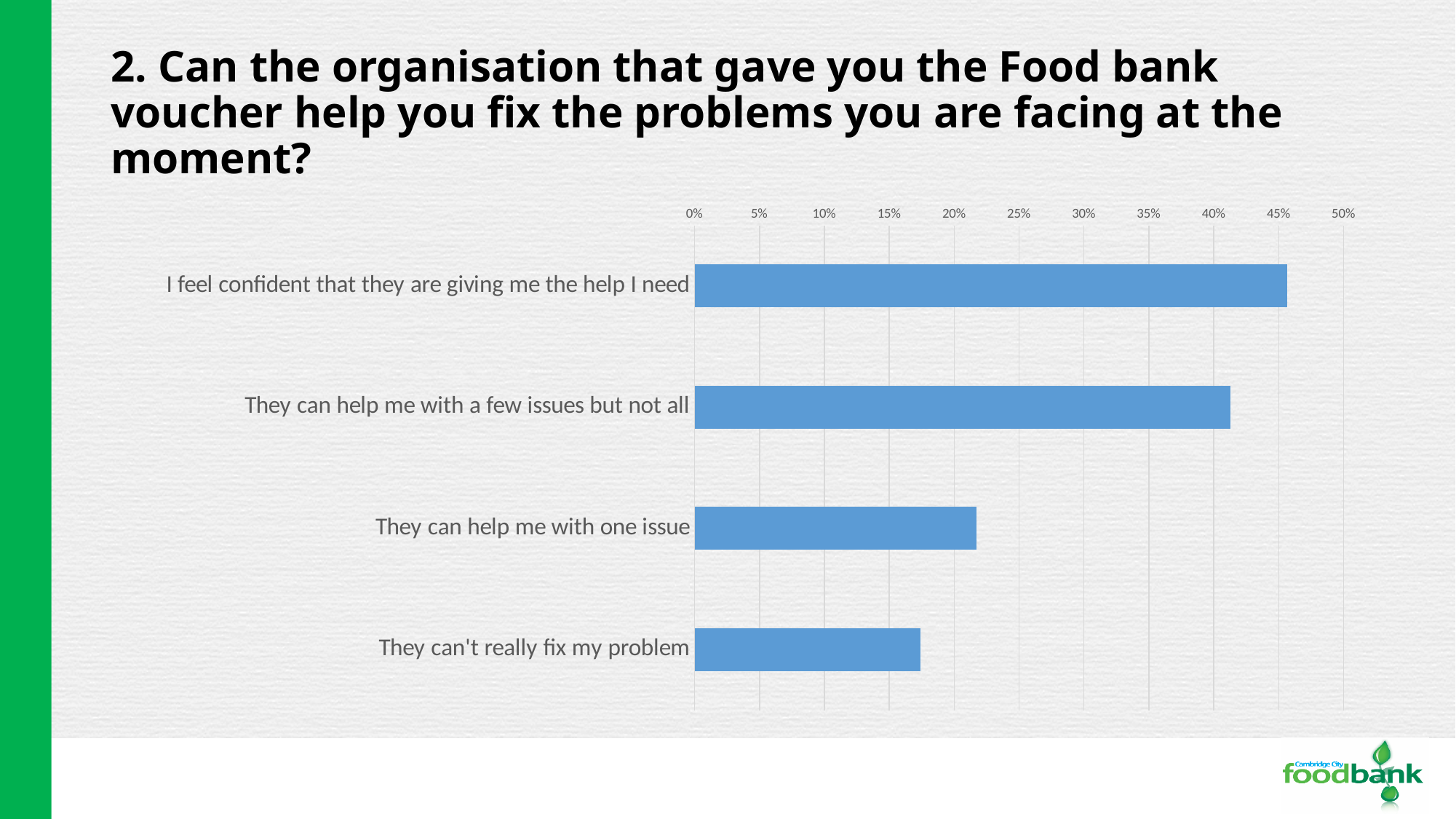
What kind of chart is shown on the slide? bar chart How many categories are plotted in the chart? 4 Which category has the highest value? I feel confident that they are giving me the help I need Is the value for "They can help me with one issue" greater or less than 25%? less Is the value for "I feel confident that they are giving me the help I need" greater or less than 40%? greater Is the value for "They can help me with a few issues but not all" greater or less than 45%? less Which category has the lowest value? They can't really fix my problem What is the maximum value shown on the percentage axis of the chart? 50% Which is larger: the value for "They can help me with one issue" or the value for "They can't really fix my problem"? They can help me with one issue Which is larger: the value for "They can help me with a few issues but not all" or the value for "They can help me with one issue"? They can help me with a few issues but not all